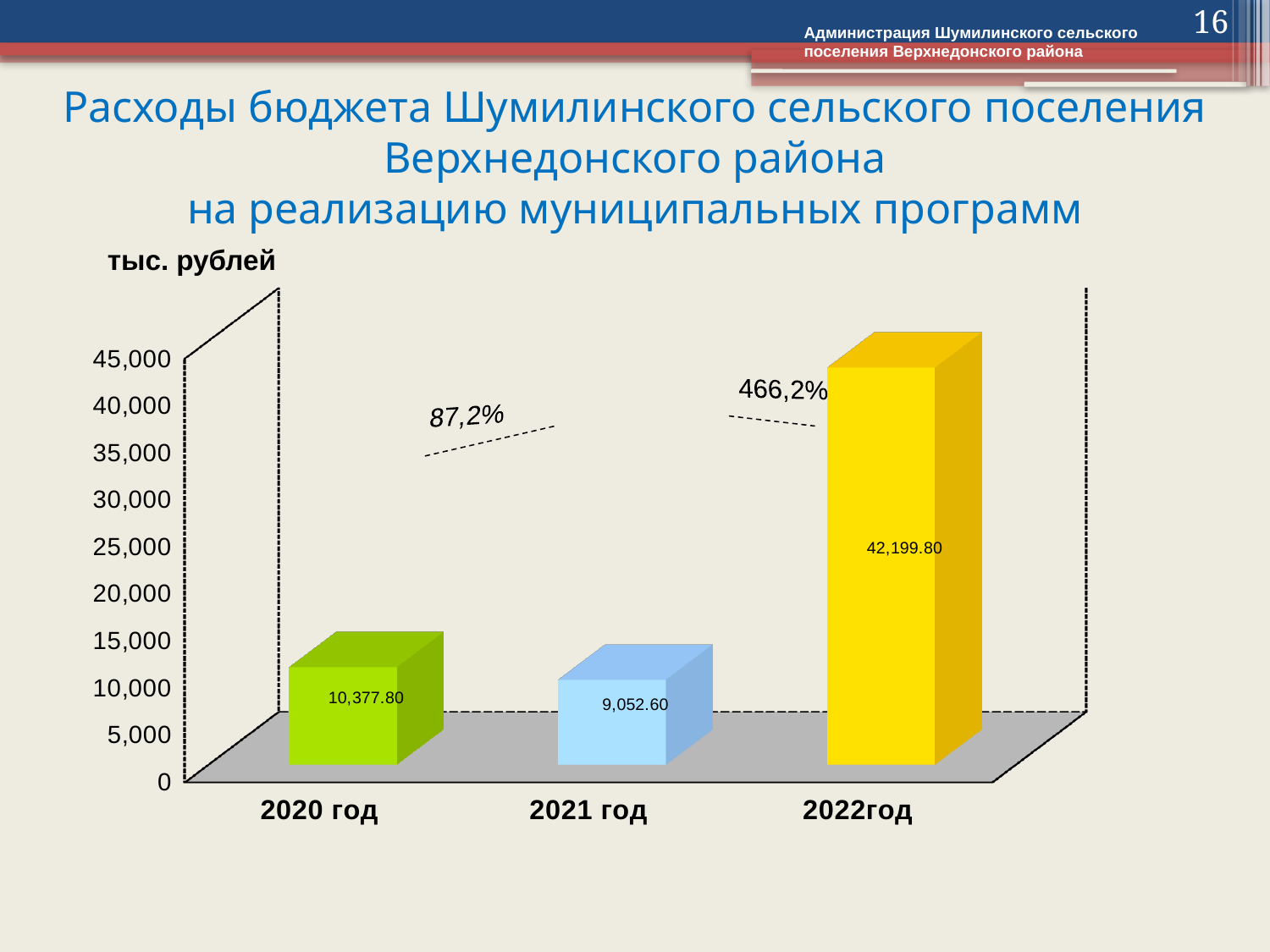
Which is larger, the value for 2020 год or the value for 2021 год? 2020 год Which year has the highest value? 2022год Is the value for 2022год greater or less than 40,000? greater What is the value for 2022год? 42,199.80 What is the difference between the values for 2020 год and 2021 год? 1,325.20 What is the value for 2020 год? 10,377.80 What is the difference between the values for 2022год and 2020 год? 31,822.00 What unit of measurement is indicated above the chart? тыс. рублей How many years are shown on the chart? 3 What kind of chart is shown on the slide? bar chart What is the value for 2021 год? 9,052.60 Which year has the lowest value? 2021 год